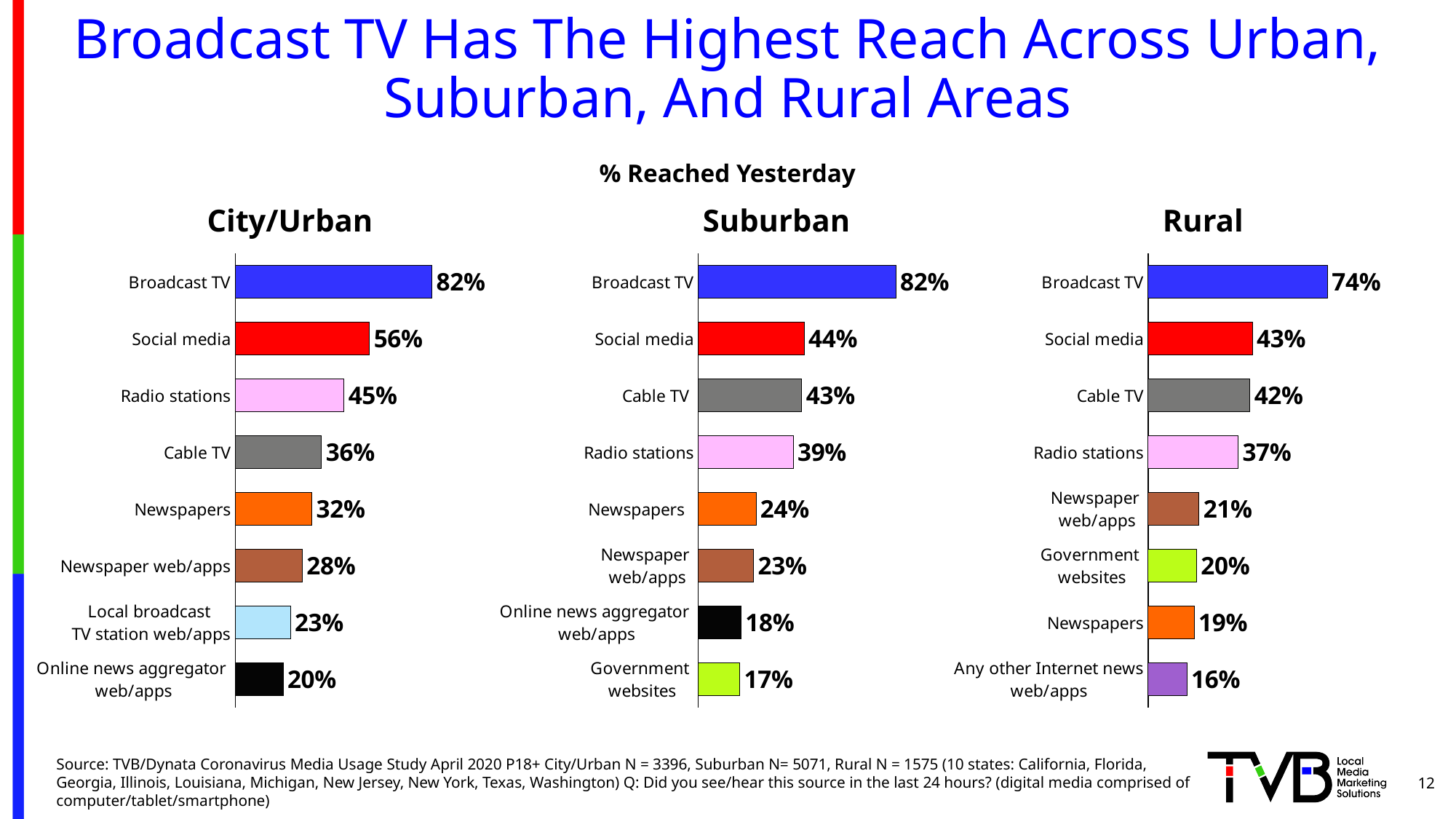
In the Rural chart, which category has the highest value? Broadcast TV In the Rural chart, what is the value for Government websites? 20% What kind of chart is the Rural chart? Bar chart In the City/Urban chart, what is the difference between Broadcast TV and Social media? 26% In the Suburban chart, what is the value for Cable TV? 43% In the City/Urban chart, what is the value for Local broadcast TV station web/apps? 23% In the Rural chart, what is the difference between Cable TV and Radio stations? 5% Which is larger: Newspapers in the City/Urban chart or Newspapers in the Suburban chart? City/Urban In the Suburban chart, which category has the lowest value? Government websites What is the shared subtitle above the three charts? % Reached Yesterday In the City/Urban chart, what is the value for Social media? 56% How many categories are shown in the Suburban chart? 8